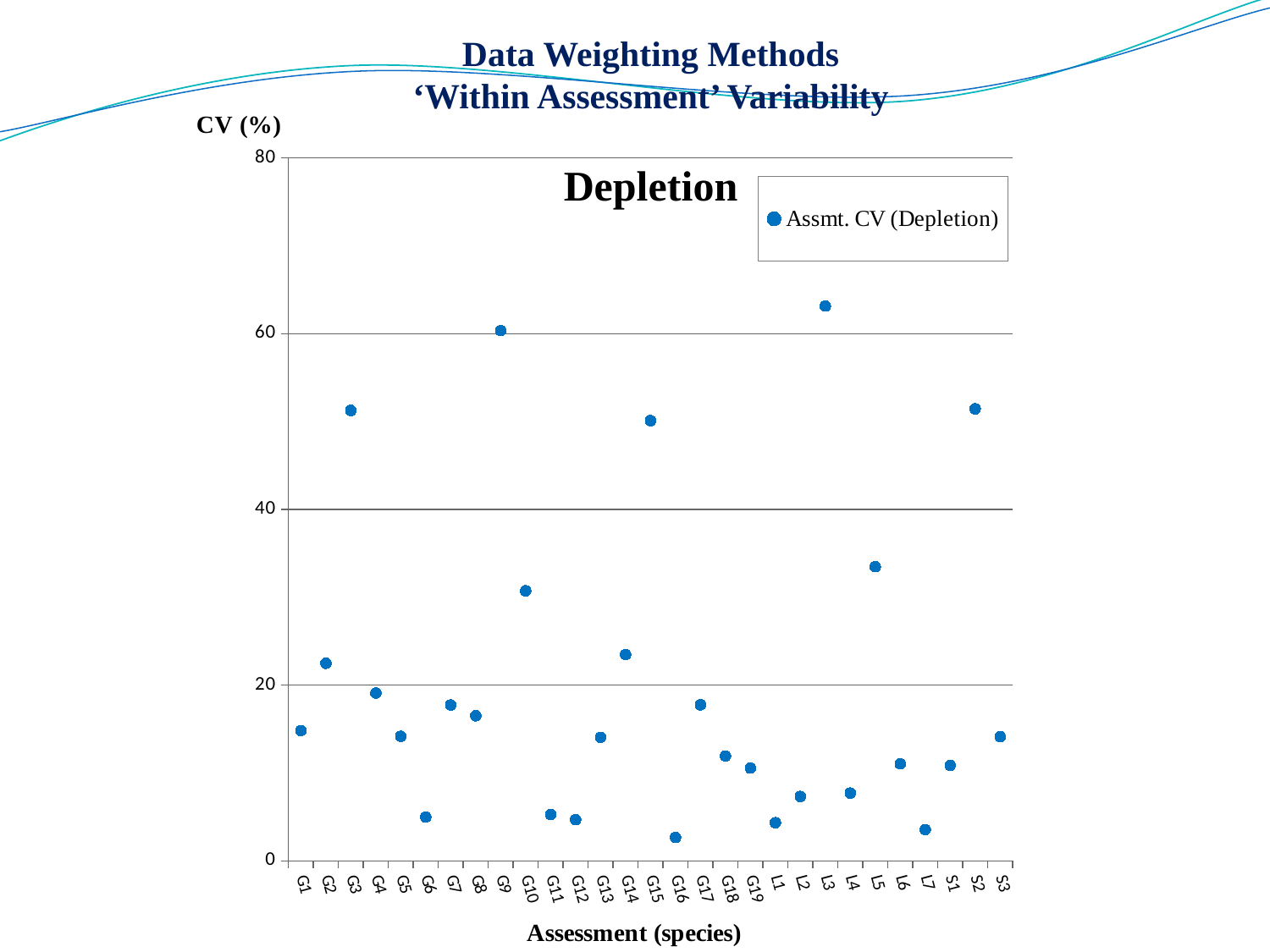
Is the value for G10 greater or less than 20? greater What kind of chart is shown on the slide? scatter chart Is the value for S2 greater or less than 40? greater Which assessment has the lowest CV value? G16 Which has the larger CV value, G3 or G4? G3 Which assessment has the highest CV value? L3 Is the value for G6 greater or less than 20? less How many assessments (categories) are plotted on the x axis? 29 How many series does the legend list? 1 Which has the larger CV value, G14 or G13? G14